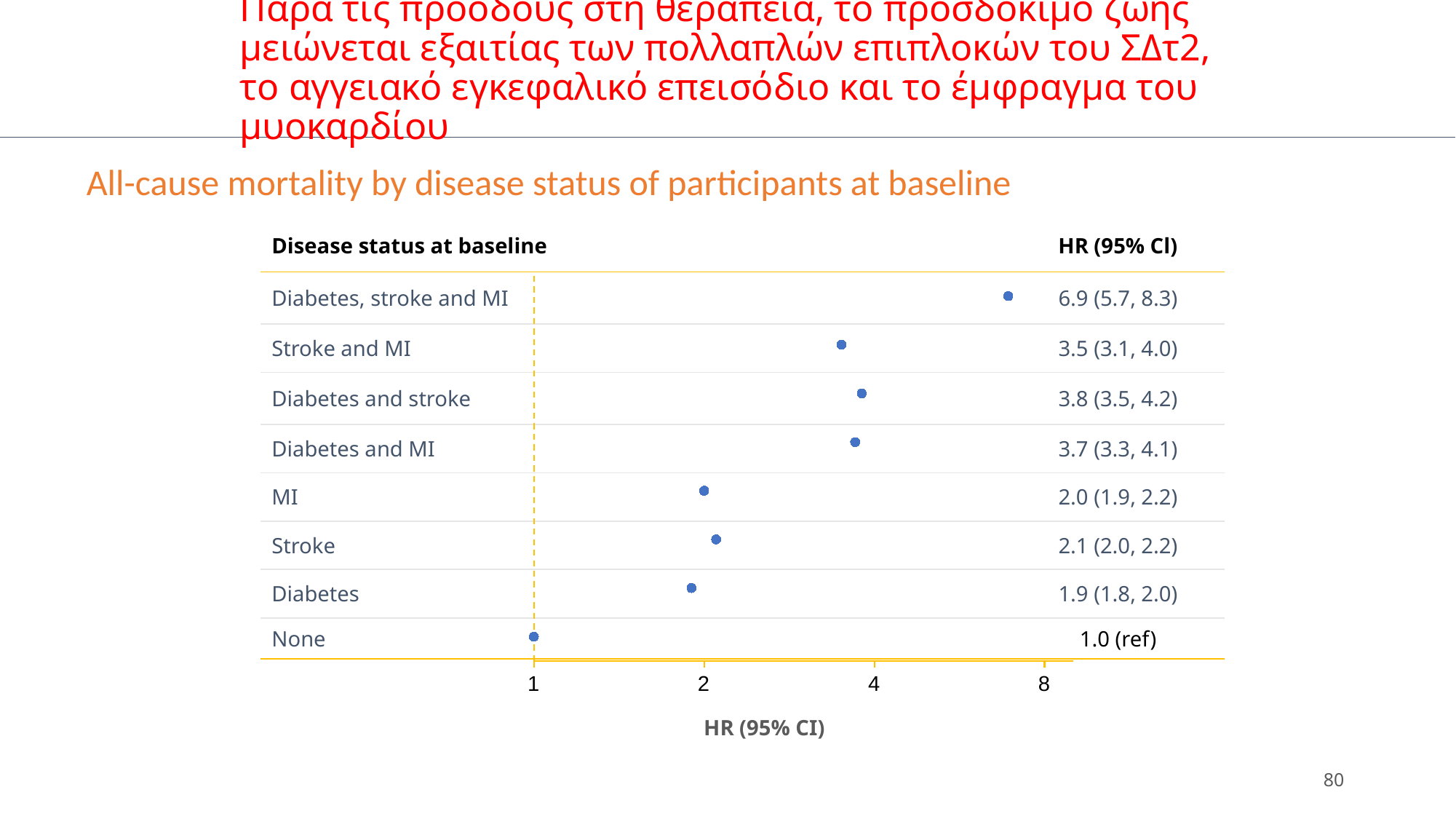
How many disease status groups are plotted in the chart? 8 What is the difference between the HR point estimates for 'Stroke' and 'Diabetes'? 0.2 What is the HR for the 'Diabetes, stroke and MI' group? 6.9 (5.7, 8.3) What is the HR for the 'Diabetes' group? 1.9 (1.8, 2.0) What kind of chart is shown on the slide? Dot plot (forest plot) Which has a larger HR point estimate: 'Diabetes and stroke' or 'Diabetes and MI'? Diabetes and stroke What is the HR for the 'Stroke and MI' group? 3.5 (3.1, 4.0) What is the label of the x axis? HR (95% CI) Is the HR for 'Diabetes, stroke and MI' greater or less than 4? greater What is the difference between the HR point estimates for 'Diabetes, stroke and MI' and 'Stroke and MI'? 3.4 Which disease status group has the lowest HR? None Which disease status group has the highest HR? Diabetes, stroke and MI